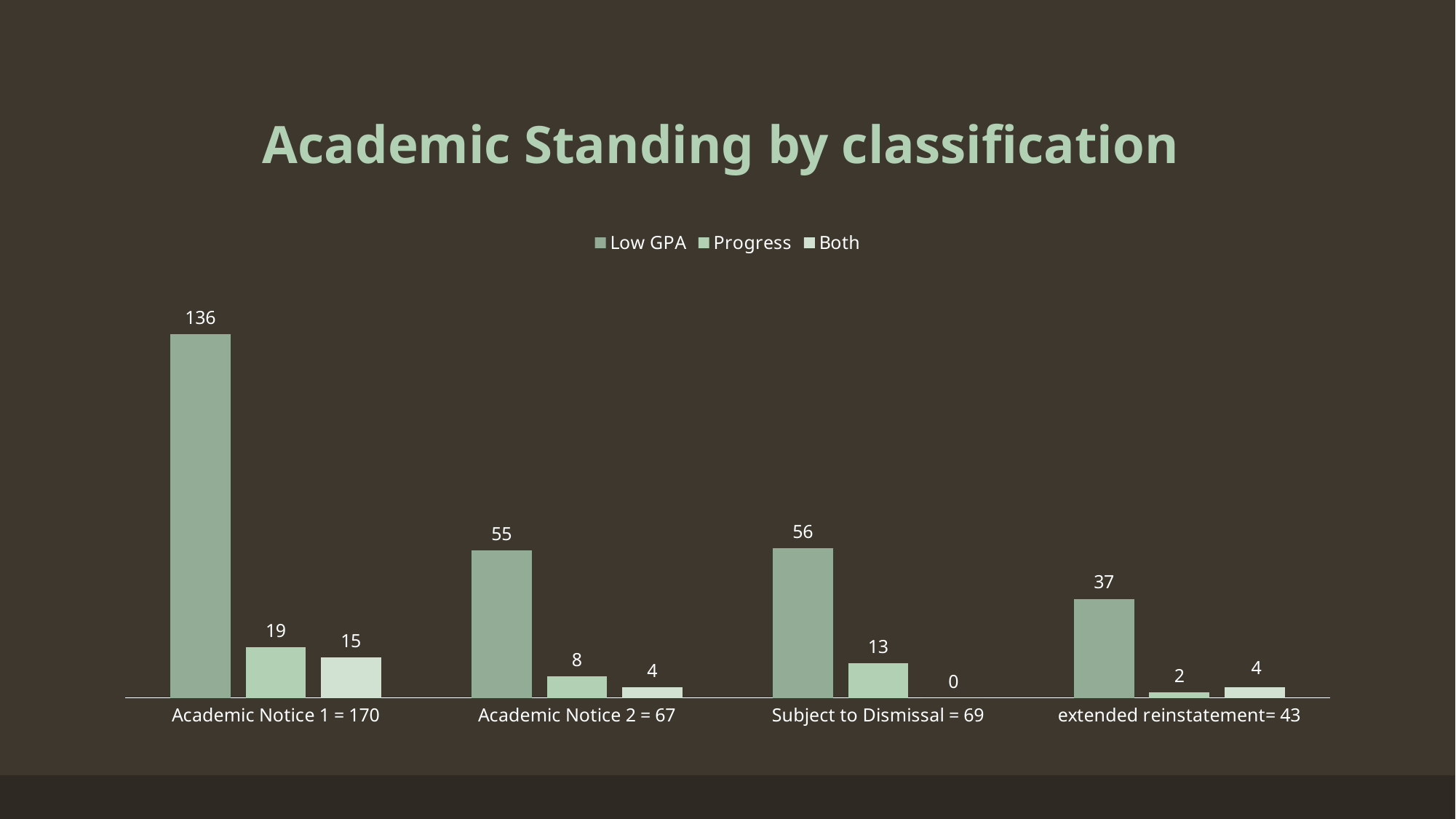
Which category has the lowest Progress value? extended reinstatement= 43 Which is larger: the Progress value for Academic Notice 1 = 170 or the Progress value for Academic Notice 2 = 67? Academic Notice 1 = 170 What is the Both value for extended reinstatement= 43? 4 What is the Progress value for Subject to Dismissal = 69? 13 What is the Both value for Subject to Dismissal = 69? 0 How many categories are shown on the x axis? 4 How many series does the legend list? 3 What is the Low GPA value for Academic Notice 1 = 170? 136 Which category has the highest Low GPA value? Academic Notice 1 = 170 What is the title of the chart? Academic Standing by classification What is the difference between the Low GPA values for Academic Notice 1 = 170 and Academic Notice 2 = 67? 81 What kind of chart is shown on the slide? bar chart